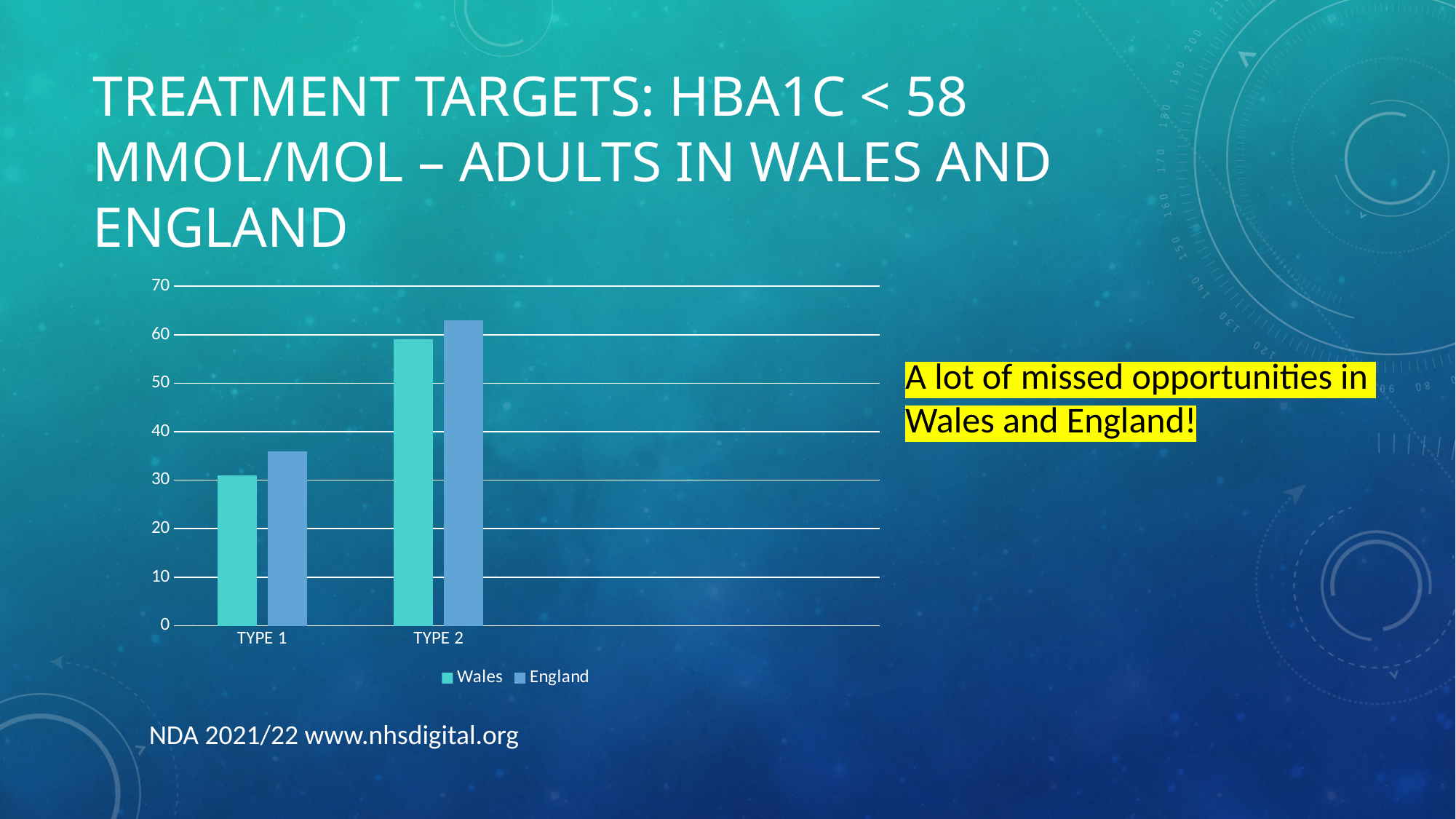
Which category has the highest value for Wales? TYPE 2 How many series does the legend list? 2 What kind of chart is shown on the slide? bar chart For TYPE 2, which is larger, Wales or England? England How many categories are shown on the x axis? 2 For TYPE 1, which is larger, Wales or England? England Do the values for Wales rise or fall from TYPE 1 to TYPE 2? rise Is the value for Wales in TYPE 1 greater or less than 40? less Is the value for England in TYPE 2 greater or less than 50? greater Is the value for Wales in TYPE 2 greater or less than 50? greater Which series are listed in the legend? Wales and England Which category has the lowest value for England? TYPE 1